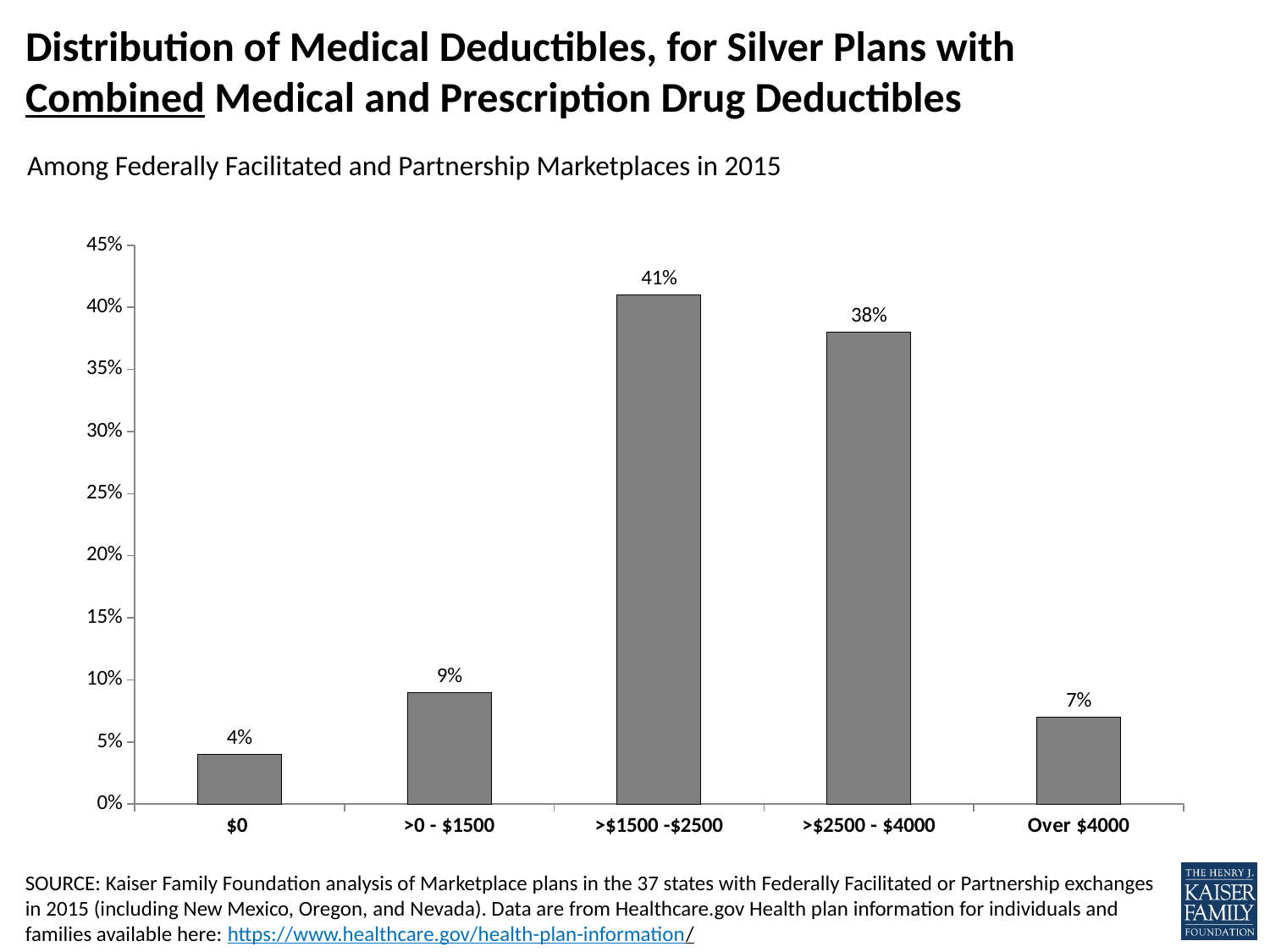
What percentage of silver plans have a combined deductible of Over $4000? 7% What percentage of silver plans have a combined deductible of >$1500 -$2500? 41% How many deductible categories are shown on the x axis? 5 Which category has a larger share: >0 - $1500 or Over $4000? >0 - $1500 Which deductible category has the lowest share of plans? $0 What is the maximum value shown on the y axis? 45% What percentage of silver plans have a combined deductible of $0? 4% What is the difference in percentage points between the >$1500 -$2500 and >$2500 - $4000 categories? 3 percentage points Is the value for >$2500 - $4000 greater or less than 35%? greater What is the combined share of plans in the >$1500 -$2500 and >$2500 - $4000 categories? 79% What kind of chart is shown on the slide? Bar chart Which deductible category has the highest share of plans? >$1500 -$2500